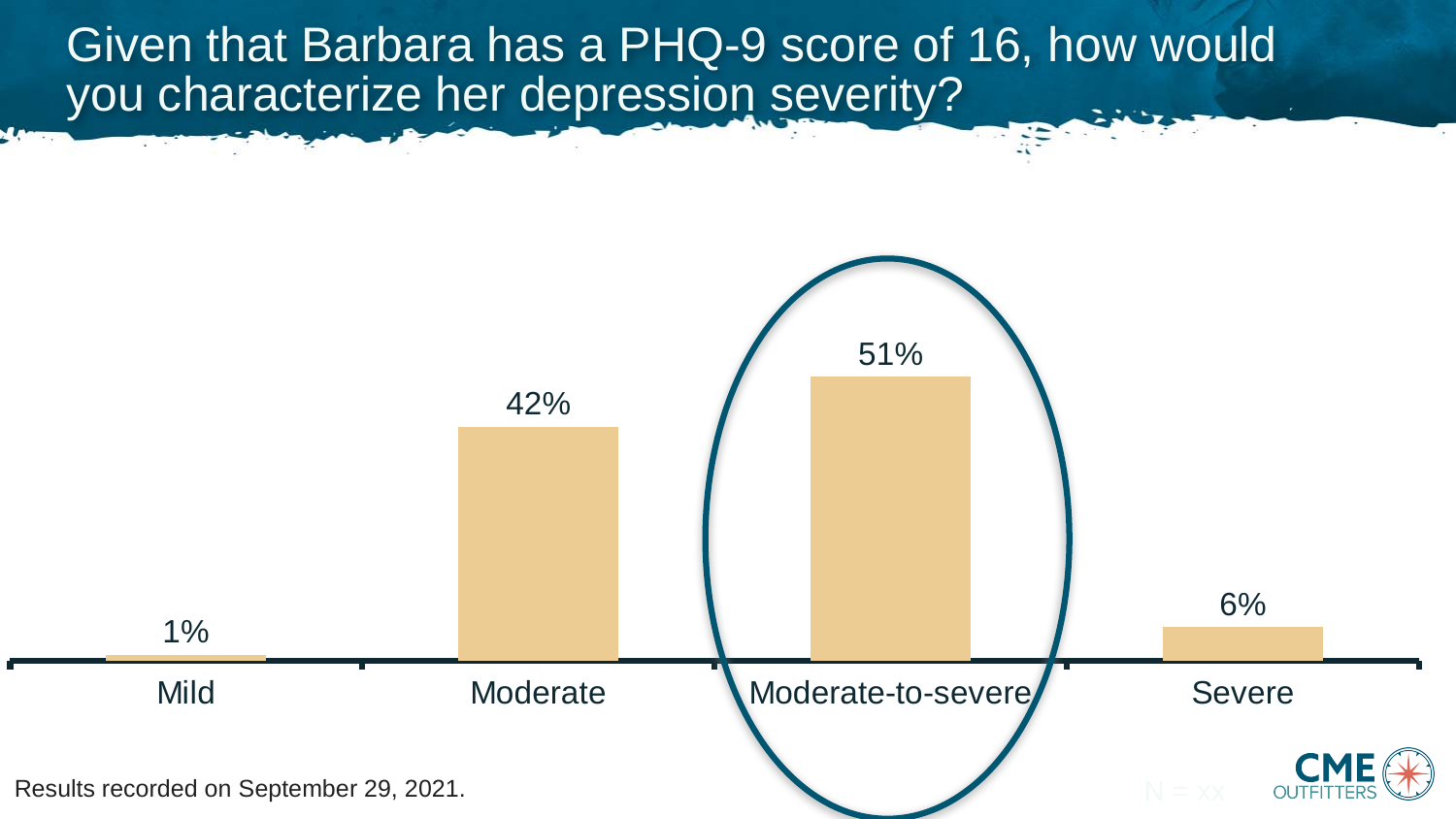
What percentage of respondents chose Moderate-to-severe? 51% Which category has the lowest value? Mild What percentage of respondents chose Mild? 1% Which category on the chart is circled? Moderate-to-severe What is the difference between the Severe and Mild values? 5% What percentage of respondents chose Severe? 6% Which is larger, the value for Moderate or the value for Severe? Moderate What kind of chart is shown on the slide? Bar chart What is the difference between the Moderate-to-severe and Moderate values? 9% How many categories are shown on the chart? 4 Which category has the highest value? Moderate-to-severe What percentage of respondents chose Moderate? 42%